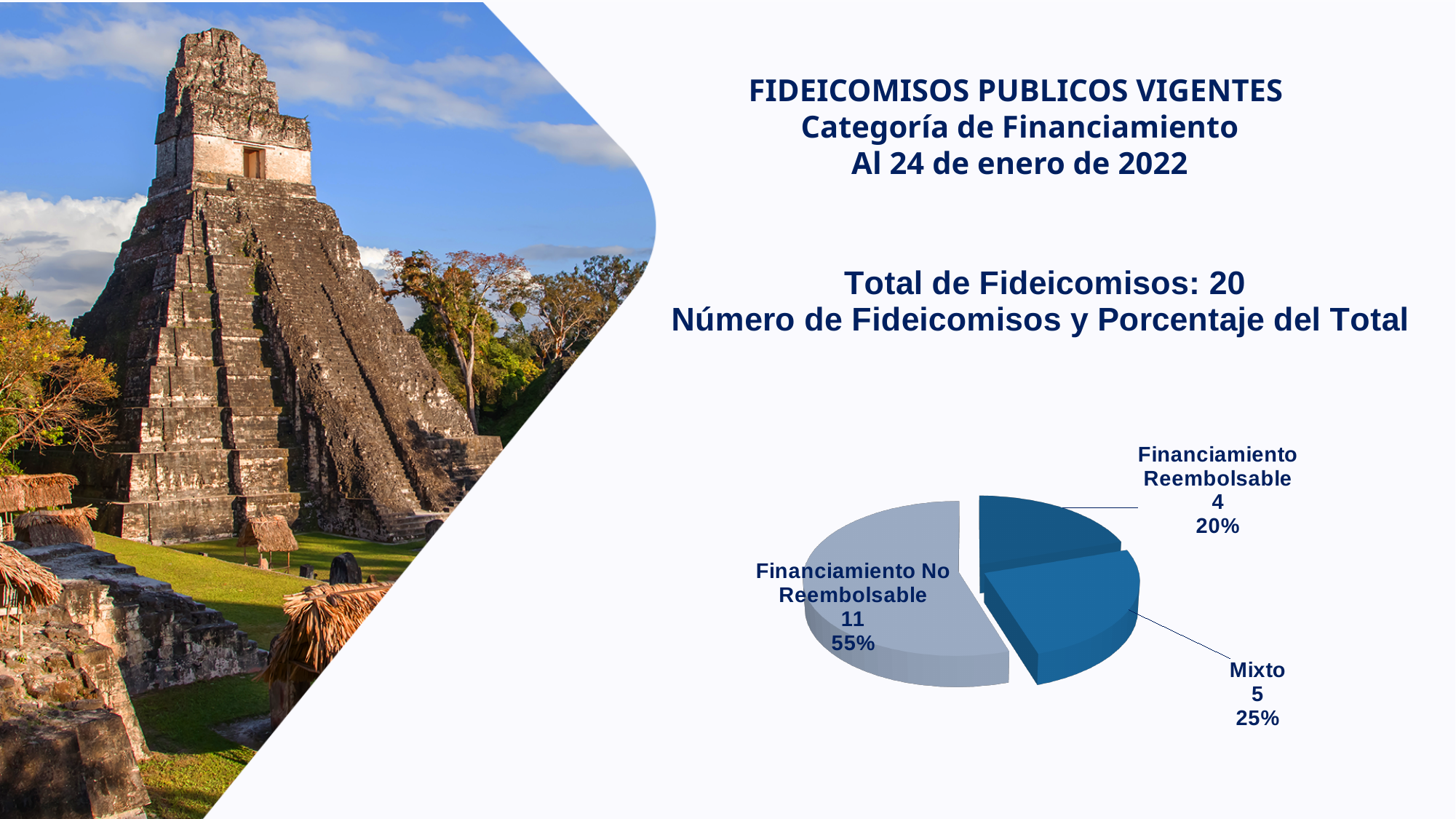
What percentage of the total does the Mixto slice represent? 25% Which category has the smallest number of fideicomisos? Financiamiento Reembolsable How many fideicomisos are in the Financiamiento Reembolsable category? 4 What percentage of the total does the Financiamiento Reembolsable slice represent? 20% What kind of chart is shown on the slide? pie chart What is the difference in the number of fideicomisos between Financiamiento No Reembolsable and Mixto? 6 What percentage of the total does the Financiamiento No Reembolsable slice represent? 55% Which category has the largest number of fideicomisos? Financiamiento No Reembolsable What is the total number of fideicomisos across all categories? 20 How many categories does the pie chart show? 3 How many fideicomisos are in the Financiamiento No Reembolsable category? 11 Which has more fideicomisos, Mixto or Financiamiento Reembolsable? Mixto